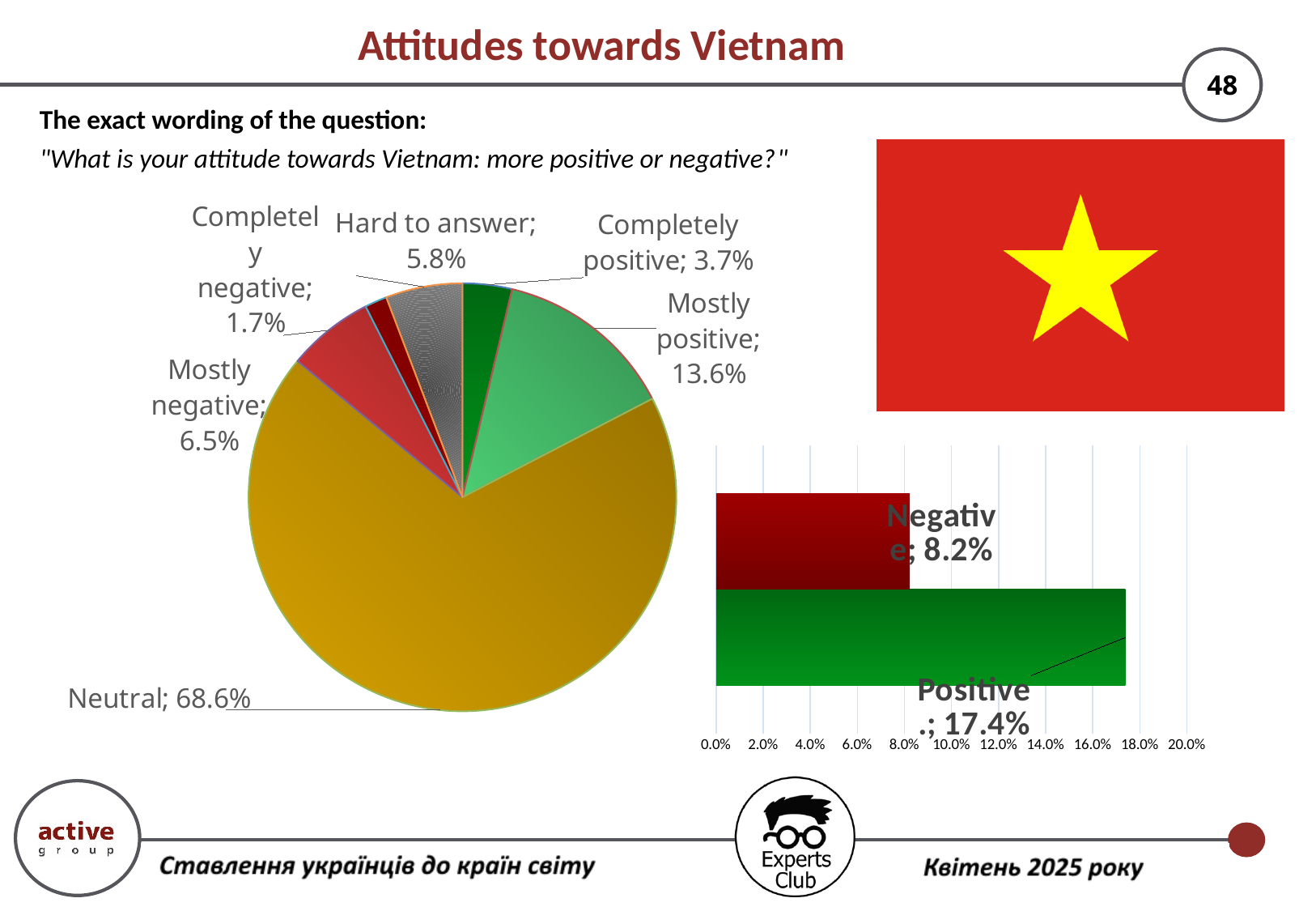
In the bar chart on the right, what is the difference between "Positive" and "Negative"? 9.2% In the pie chart on the left, what is the value for "Completely negative"? 1.7% In the pie chart on the left, how many categories are shown? 6 In the pie chart on the left, what share of respondents answered "Neutral"? 68.6% In the bar chart on the right, what is the value for "Positive"? 17.4% In the pie chart on the left, which is larger: "Mostly negative" or "Completely positive"? Mostly negative In the pie chart on the left, which category has the largest slice? Neutral In the pie chart on the left, what is the value for "Hard to answer"? 5.8% What type of chart is shown on the right side of the slide? Bar chart In the pie chart on the left, what is the difference between "Mostly positive" and "Mostly negative"? 7.1% In the pie chart on the left, what is the value for "Mostly positive"? 13.6% In the pie chart on the left, which category has the smallest slice? Completely negative